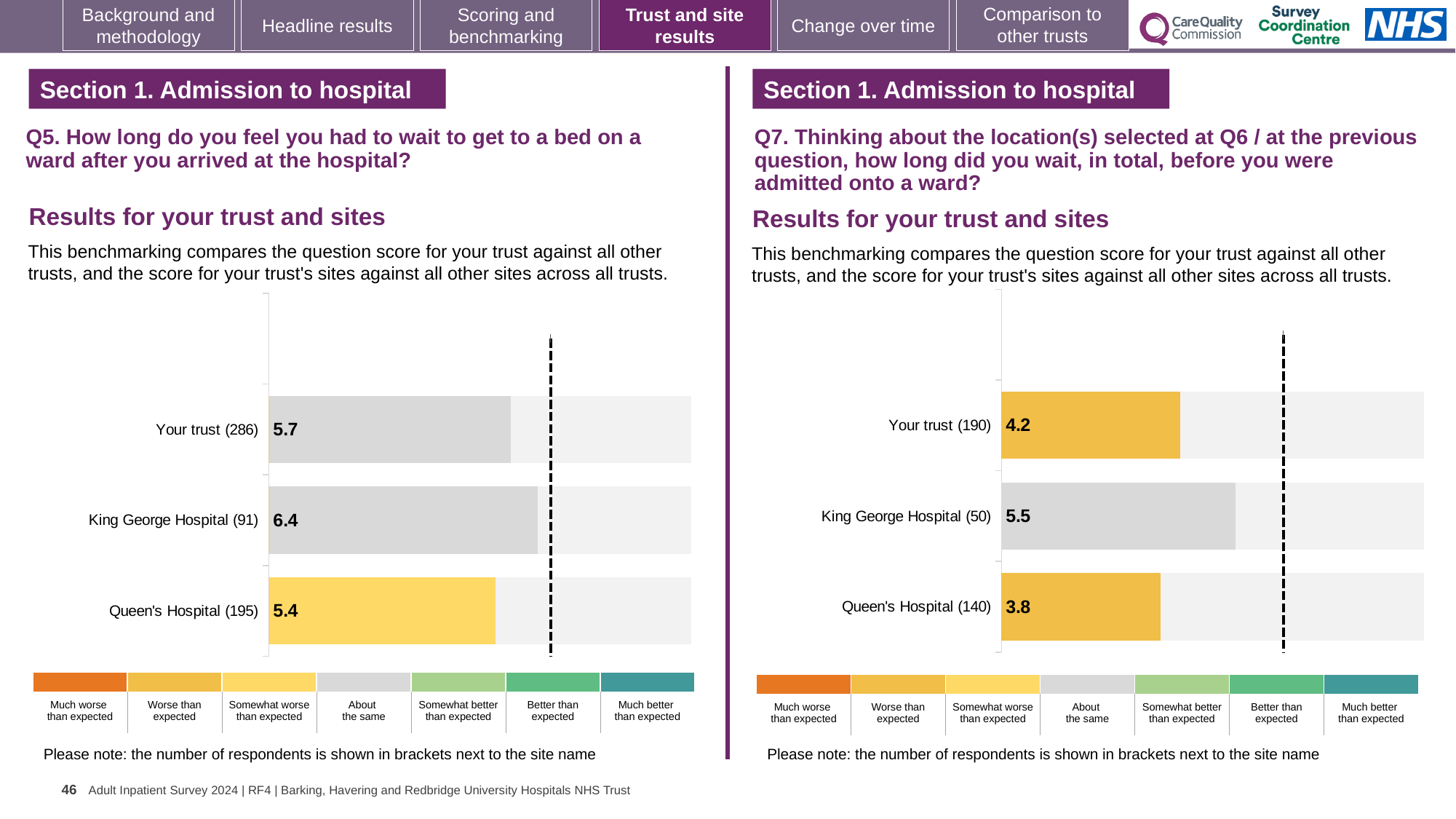
On the Q5 chart (left), which site or trust has the lowest score? Queen's Hospital On the Q5 chart (left), what is the difference between the scores for King George Hospital and Queen's Hospital? 1.0 On the Q7 chart (right), how many respondents are shown in brackets for Your trust? 190 On the Q7 chart (right), which site or trust has the highest score? King George Hospital How many bars are plotted on the Q5 chart (left)? 3 On the Q5 chart (left), how many respondents are shown in brackets for Queen's Hospital? 195 On the Q7 chart (right), what is the difference between the scores for King George Hospital and Your trust? 1.3 On the Q5 chart (left), what is the score for Your trust? 5.7 On the Q5 chart (left), what is the score for King George Hospital? 6.4 On the Q7 chart (right), what is the score for Queen's Hospital? 3.8 On the Q7 chart (right), which has the larger score, Your trust or Queen's Hospital? Your trust What kind of chart is used on the Q7 chart (right)? Bar chart